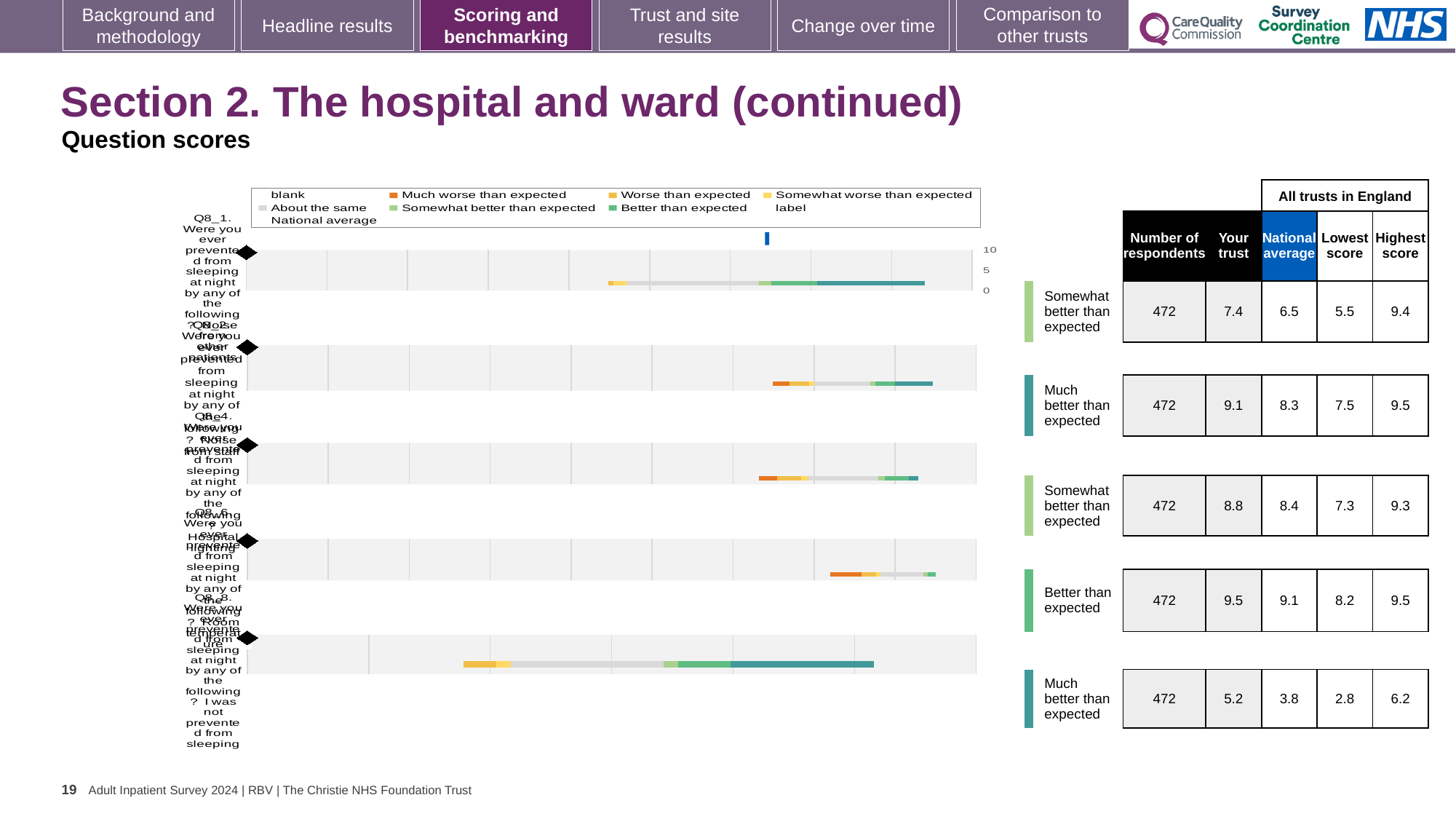
In the table beside the chart, what is the national average for the second row? 8.3 In the table beside the chart, what is the difference between the 'Your trust' score and the national average in the bottom row? 1.4 In the table beside the chart, what is the 'Your trust' score for the bottom row? 5.2 In the table beside the chart, is the 'Your trust' score in the first row larger or smaller than the national average in that row? larger In the table beside the chart, what is the number of respondents shown for the first row? 472 In the table beside the chart, what is the highest score shown for the fourth row? 9.5 Which legend entry is shown in dark orange in the chart's legend? Much worse than expected How many horizontal bars are plotted in the chart? 5 In the table beside the chart, which row has the lowest 'Your trust' score? the bottom row (5.2) What kind of chart is shown on the slide? bar chart Which legend entry is shown in light grey in the chart's legend? About the same